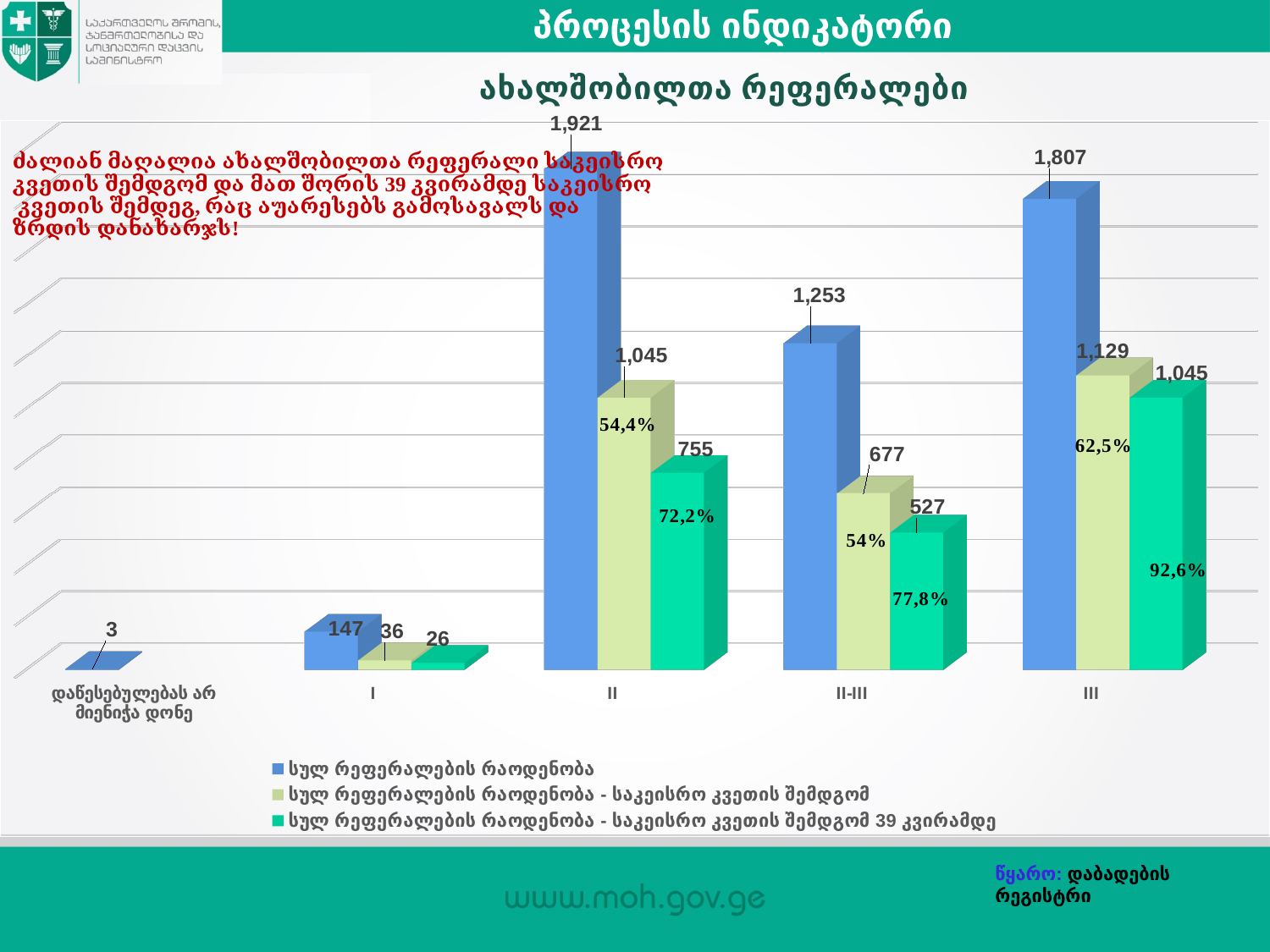
Which category has the highest value for the blue series (სულ რეფერალების რაოდენობა)? II What is the title of the chart? ახალშობილთა რეფერალები Which category has the lowest value for the blue series (სულ რეფერალების რაოდენობა)? დაწესებულებას არ მიენიჭა დონე What is the difference between the blue bar and the light green bar for category III? 678 What is the value of the teal series (საკეისრო კვეთის შემდგომ 39 კვირამდე) for category III? 1,045 What percentage label is shown on the teal bar for category II-III? 77,8% Which is larger: the teal bar for category II or the teal bar for category II-III? Category II What is the value of the light green series (საკეისრო კვეთის შემდგომ) for category II-III? 677 How many categories are shown on the x axis? 5 How many series does the legend list? 3 What is the value of the blue series (სულ რეფერალების რაოდენობა) for category II? 1,921 What type of chart is shown on the slide? Bar chart